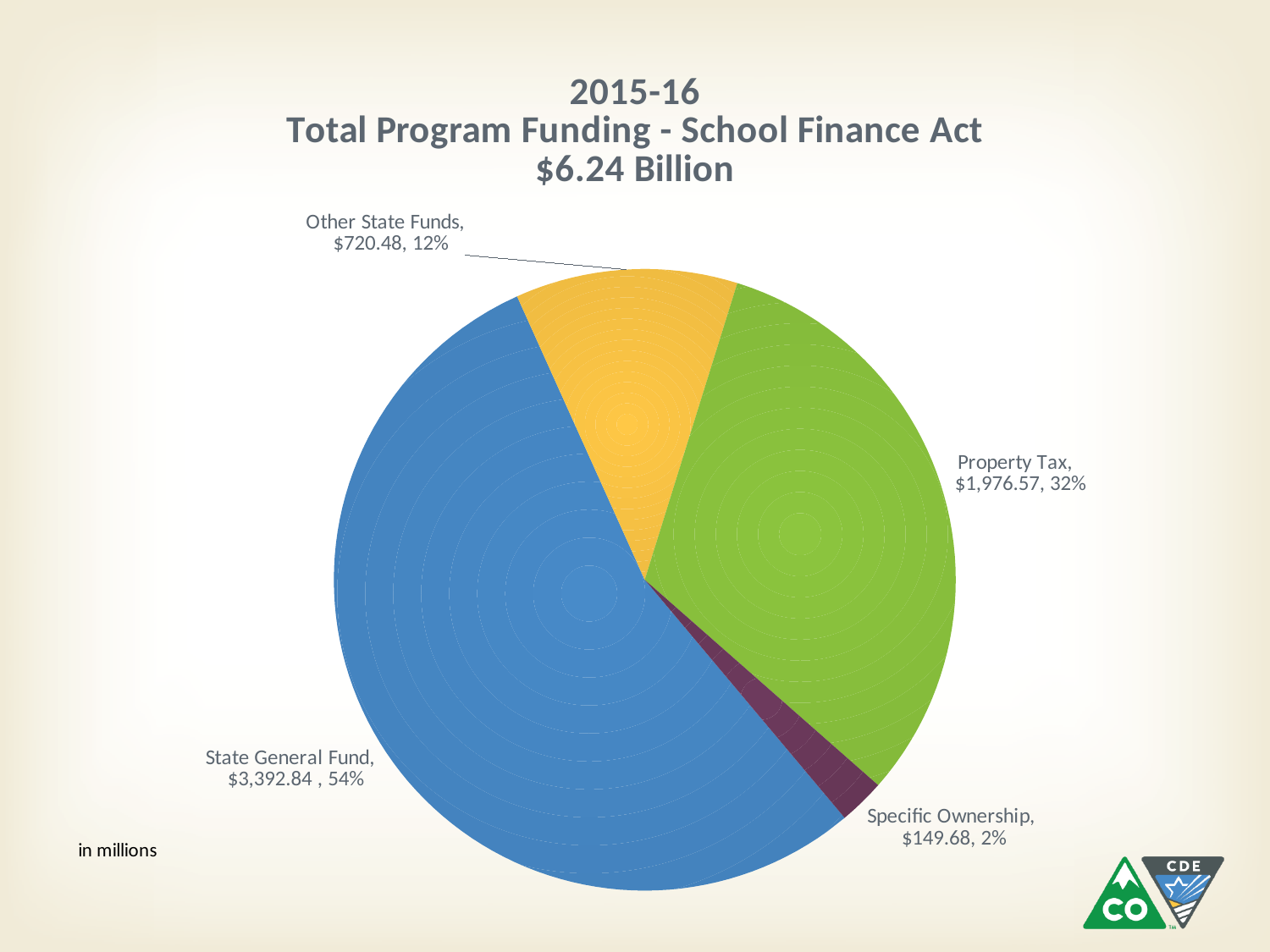
What share of the pie does Property Tax represent? 32% What kind of chart is shown on the slide? pie chart How many categories are shown in the pie chart? 4 Which is larger, Property Tax or Other State Funds? Property Tax What is the value for State General Fund? $3,392.84 What is the value for Property Tax? $1,976.57 What is the value for Other State Funds? $720.48 What share of the pie does Other State Funds represent? 12% Which category has the smallest slice of the pie? Specific Ownership What is the title of the chart? 2015-16 Total Program Funding - School Finance Act $6.24 Billion Which category has the largest slice of the pie? State General Fund What is the value for Specific Ownership? $149.68